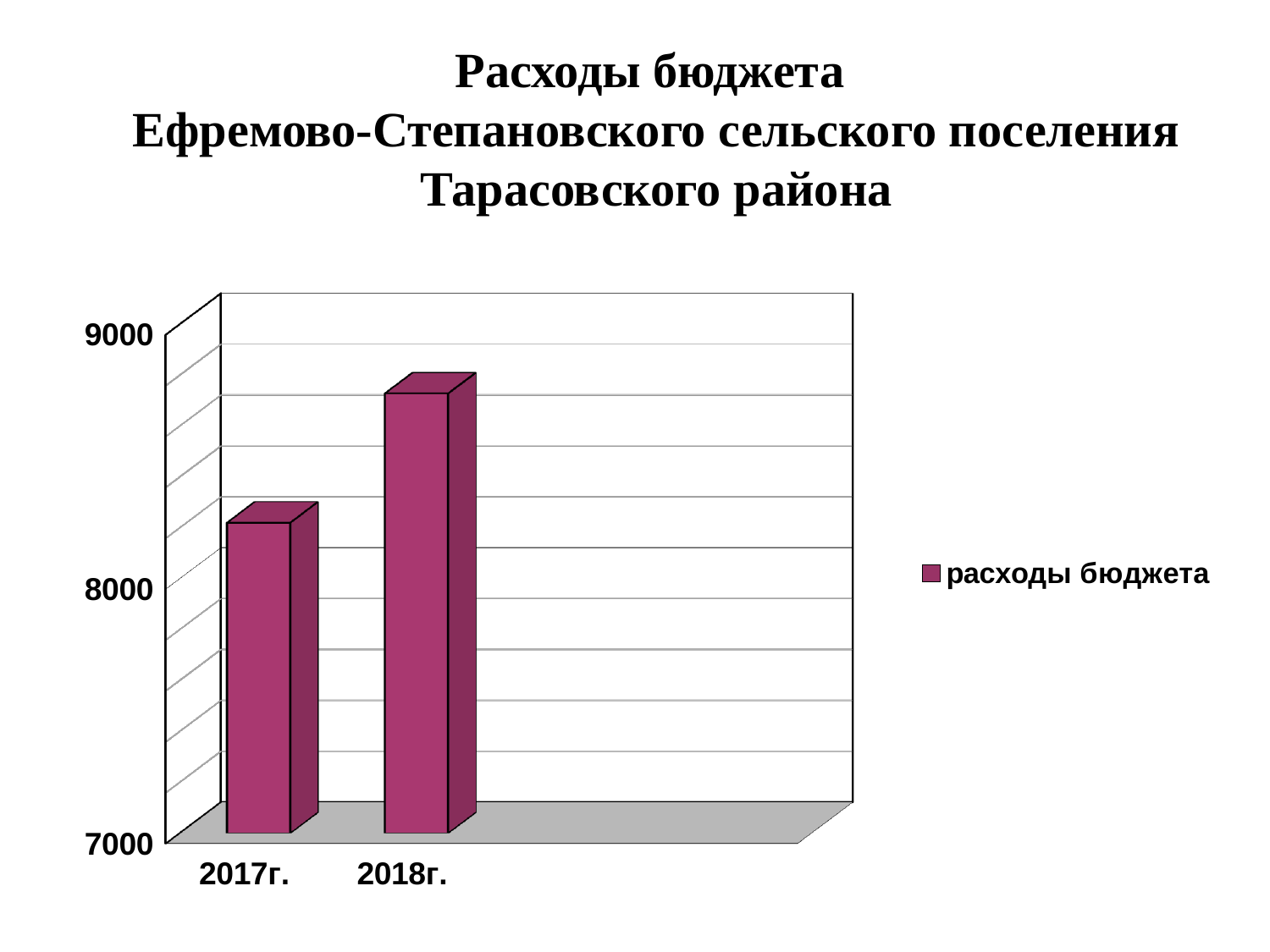
What is the name of the series shown in the legend? расходы бюджета How many series does the legend list? 1 Which year has the highest value for расходы бюджета? 2018г. What is the lowest value shown on the vertical axis? 7000 Is the value for 2018г. greater or less than 9000? less Is the value for 2017г. greater or less than 9000? less What kind of chart is shown on the slide? bar chart Which is larger, the value for 2017г. or the value for 2018г.? 2018г. Is the value for 2017г. greater or less than 8000? greater Which year has the lowest value for расходы бюджета? 2017г. Do the values rise or fall from 2017г. to 2018г.? rise How many categories are plotted on the x axis? 2